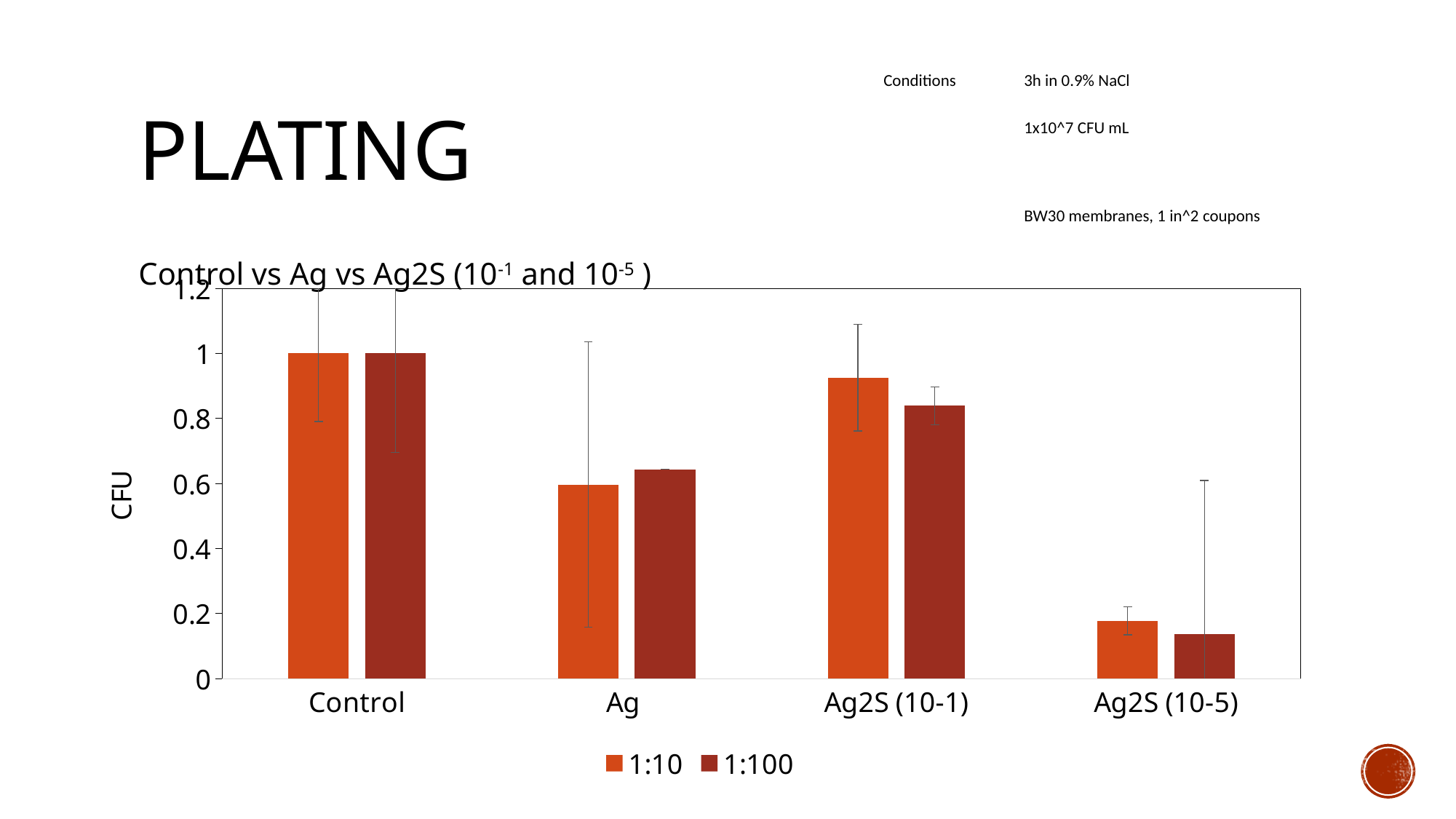
What kind of chart is shown on the slide? bar chart In the Ag2S (10-1) category, which series has the larger value: 1:10 or 1:100? 1:10 Is the value for the 1:100 series in the Ag2S (10-5) category greater or less than 0.2? less What is the label on the y axis of the chart? CFU For the 1:10 series, which is larger: the value for Ag or the value for Ag2S (10-1)? Ag2S (10-1) Which category has the lowest value for the 1:10 series? Ag2S (10-5) What is the CFU value for the 1:100 series in the Control category? 1 How many series does the chart's legend list? 2 Which category has the highest value for the 1:100 series? Control Is the value for the 1:10 series in the Ag2S (10-1) category greater or less than 0.8? greater What is the CFU value for the 1:10 series in the Control category? 1 How many categories are shown on the x axis of the chart? 4